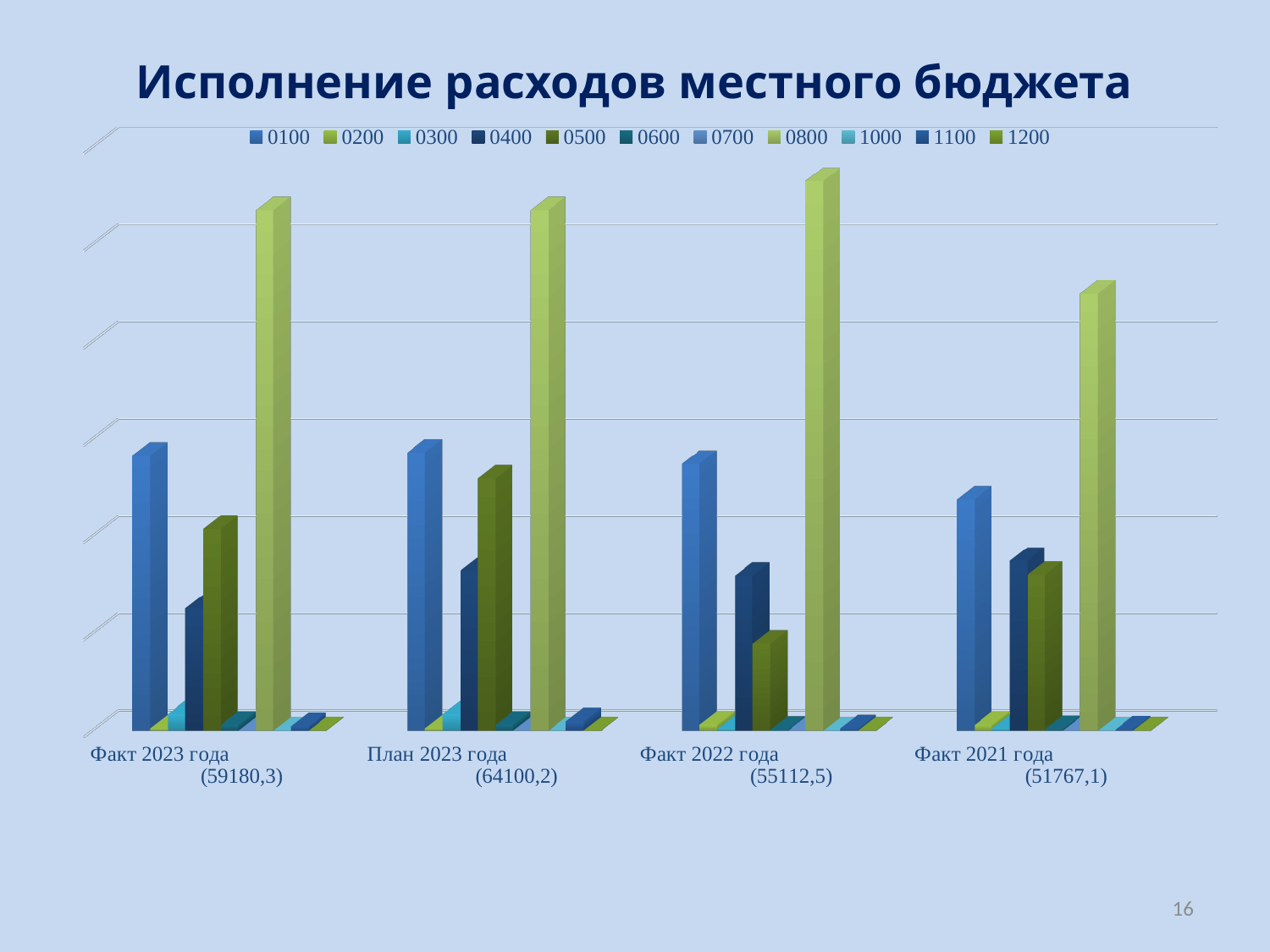
What kind of chart is shown on the slide? bar chart What total is printed in parentheses under План 2023 года? 64100,2 In the Факт 2022 года group, which bar is taller: 0400 or 0500? 0400 How many categories are shown along the x axis? 4 What total is printed in parentheses under Факт 2021 года? 51767,1 In the Факт 2023 года group, which bar is taller: 0100 or 0500? 0100 How many series does the legend list? 11 Which series has the tallest bar in the Факт 2023 года group? 0800 In which category is the 0800 bar the shortest? Факт 2021 года In which category is the 0800 bar the tallest? Факт 2022 года What is the title of the chart? Исполнение расходов местного бюджета Which category has the larger printed total: Факт 2023 года or Факт 2022 года? Факт 2023 года